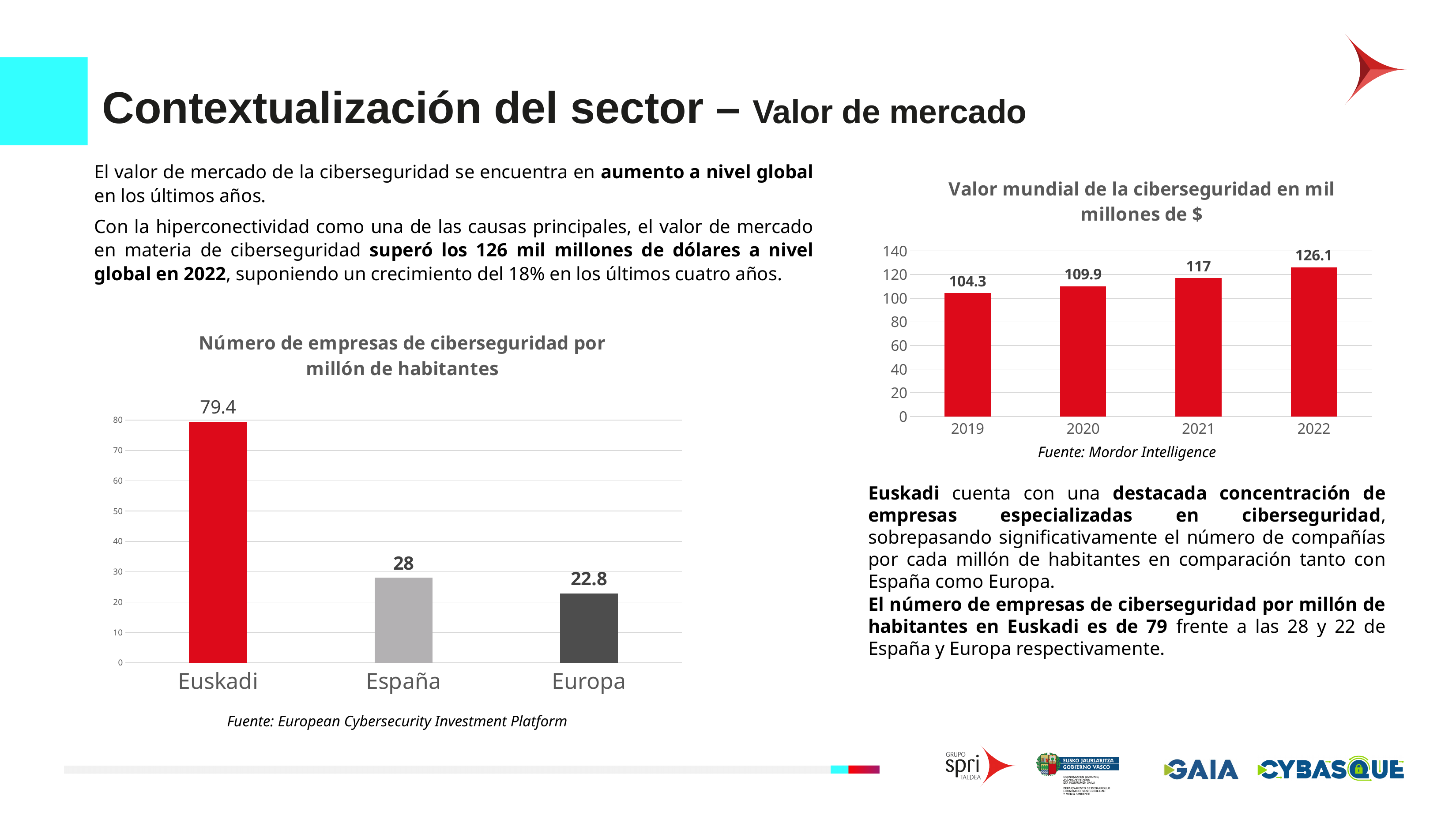
What kind of chart is 'Valor mundial de la ciberseguridad en mil millones de $'? Bar chart In the chart 'Valor mundial de la ciberseguridad en mil millones de $', do the values rise or fall from 2019 to 2022? Rise In the chart 'Valor mundial de la ciberseguridad en mil millones de $', what is the value for 2020? 109.9 In the chart 'Número de empresas de ciberseguridad por millón de habitantes', which category has the lowest value? Europa In the chart 'Número de empresas de ciberseguridad por millón de habitantes', what is the value for España? 28 In the chart 'Número de empresas de ciberseguridad por millón de habitantes', what is the difference between the values for Euskadi and Europa? 56.6 In the chart 'Valor mundial de la ciberseguridad en mil millones de $', what is the value for 2022? 126.1 In the chart 'Valor mundial de la ciberseguridad en mil millones de $', which year has the highest value? 2022 In the chart 'Número de empresas de ciberseguridad por millón de habitantes', what colour is the bar for Euskadi? Red In the chart 'Número de empresas de ciberseguridad por millón de habitantes', what is the value for Euskadi? 79.4 In the chart 'Valor mundial de la ciberseguridad en mil millones de $', what is the difference between the values for 2022 and 2019? 21.8 In the chart 'Número de empresas de ciberseguridad por millón de habitantes', how many categories are shown? 3